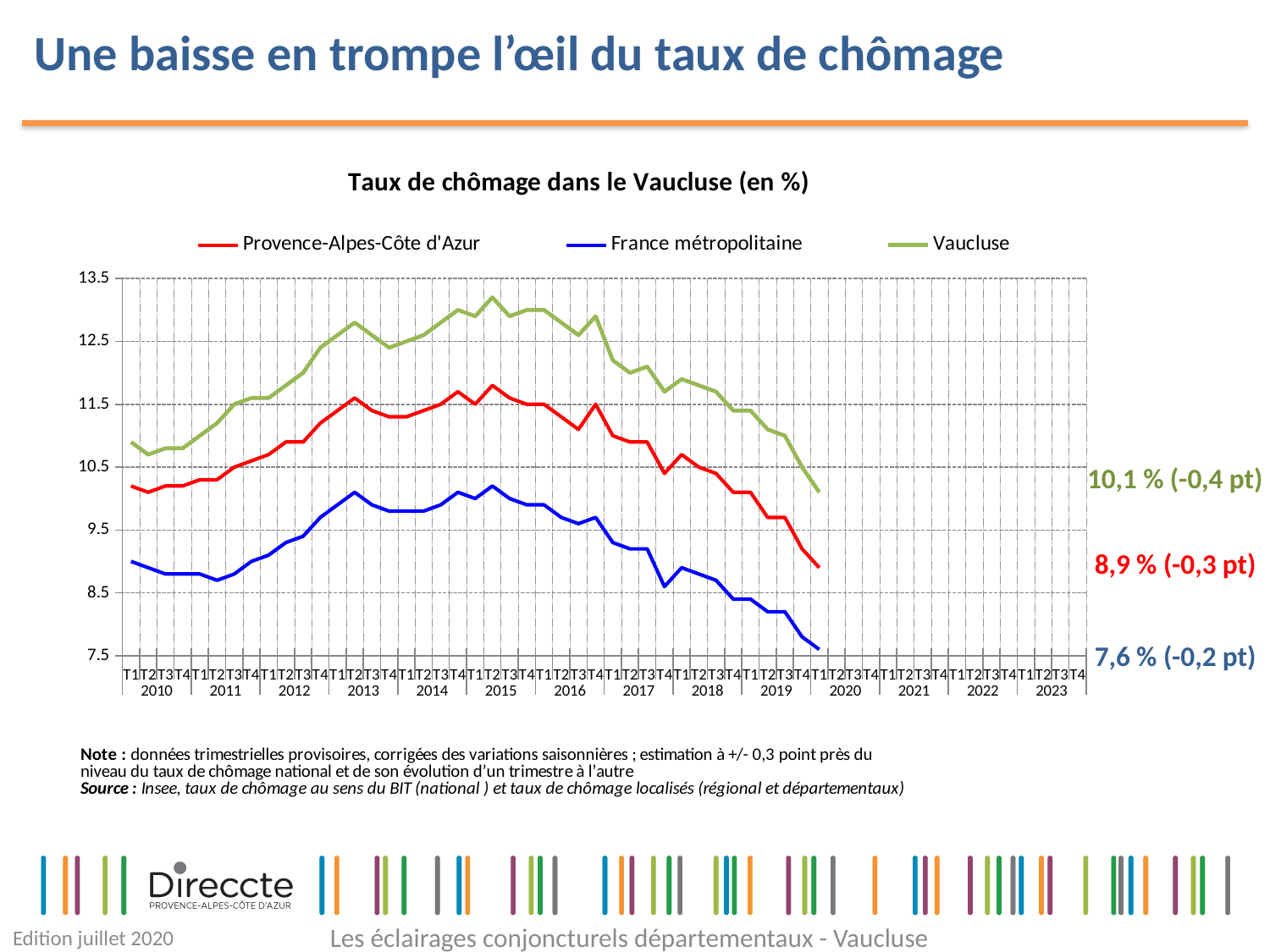
What is the latest value shown for France métropolitaine? 7,6 % How many series does the legend list? 3 What is the title of the chart? Taux de chômage dans le Vaucluse (en %) What is the latest value shown for Vaucluse? 10,1 % By how many points did the Vaucluse rate change according to the label at the end of its line? -0,4 pt What kind of chart is shown on the slide? line chart Which series is drawn in green? Vaucluse Which series has the highest value at the end of the period? Vaucluse What is the latest value shown for Provence-Alpes-Côte d'Azur? 8,9 % Is the Vaucluse value in T1 2010 greater or less than 11.5? less Is the latest value for Provence-Alpes-Côte d'Azur larger or smaller than the latest value for France métropolitaine? larger Which series has the lowest value at the end of the period? France métropolitaine